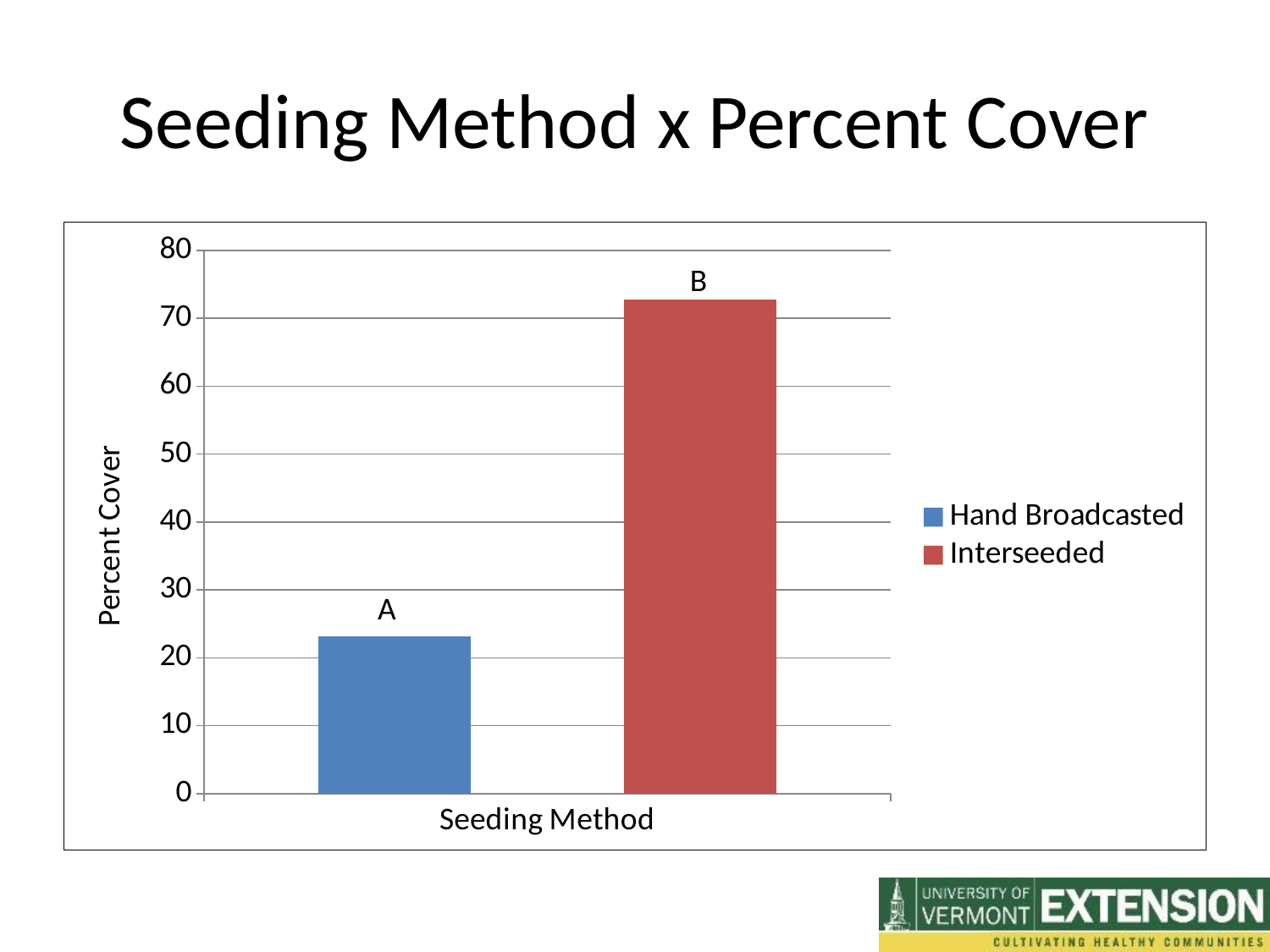
What is the title of the y axis? Percent Cover Is the percent cover for Hand Broadcasted greater or less than 20? greater Which has a larger percent cover, Hand Broadcasted or Interseeded? Interseeded How many bars are plotted in the chart? 2 Is the percent cover for Interseeded greater or less than 80? less What letter label appears above the Interseeded bar? B Which seeding method has the lowest percent cover? Hand Broadcasted How many series does the legend list? 2 Is the percent cover for Hand Broadcasted greater or less than 30? less Which seeding method has the highest percent cover? Interseeded What kind of chart is shown on the slide? bar chart